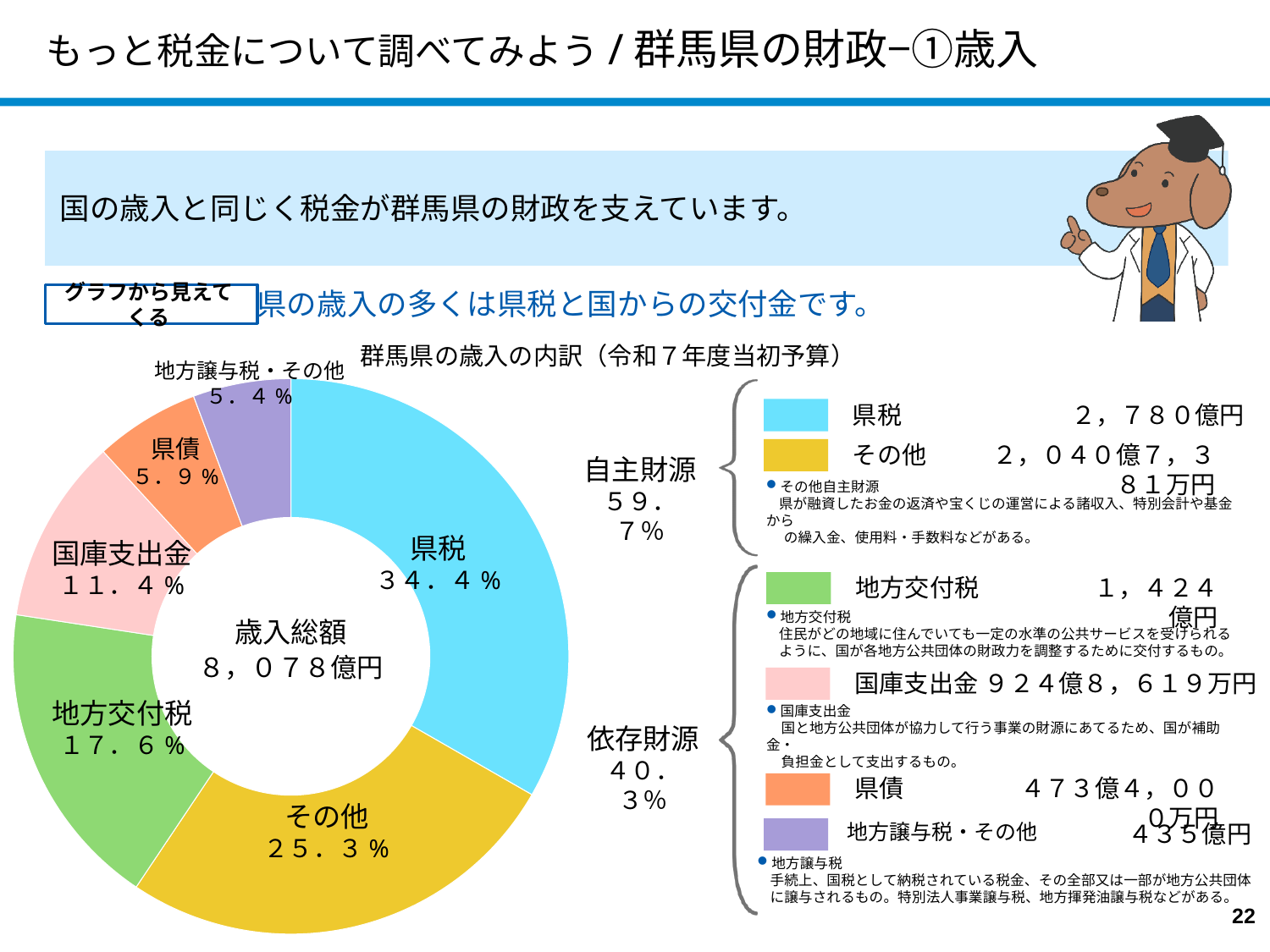
凡例によると、地方交付税の金額はいくらですか。 １，４２４億円 円グラフの中央に示されている歳入総額はいくらですか。 ８，０７８億円 このスライドのグラフはどの種類のグラフですか。 円グラフ（ドーナツグラフ） 円グラフは何項目に分かれていますか。 ６項目 円グラフで、県税を表す色は何色ですか。 水色 円グラフで、国庫支出金の割合はいくらですか。 １１．４％ 円グラフで、県債と地方譲与税・その他では、どちらの割合が大きいですか。 県債 円グラフで、地方交付税の割合はいくらですか。 １７．６％ 円グラフ「群馬県の歳入の内訳（令和７年度当初予算）」で、県税の割合はいくらですか。 ３４．４％ 円グラフで、最も割合が大きい項目はどれですか。 県税 円グラフで、最も割合が小さい項目はどれですか。 地方譲与税・その他 円グラフで、県税とその他の割合の差は何ポイントですか。 ９．１ポイント